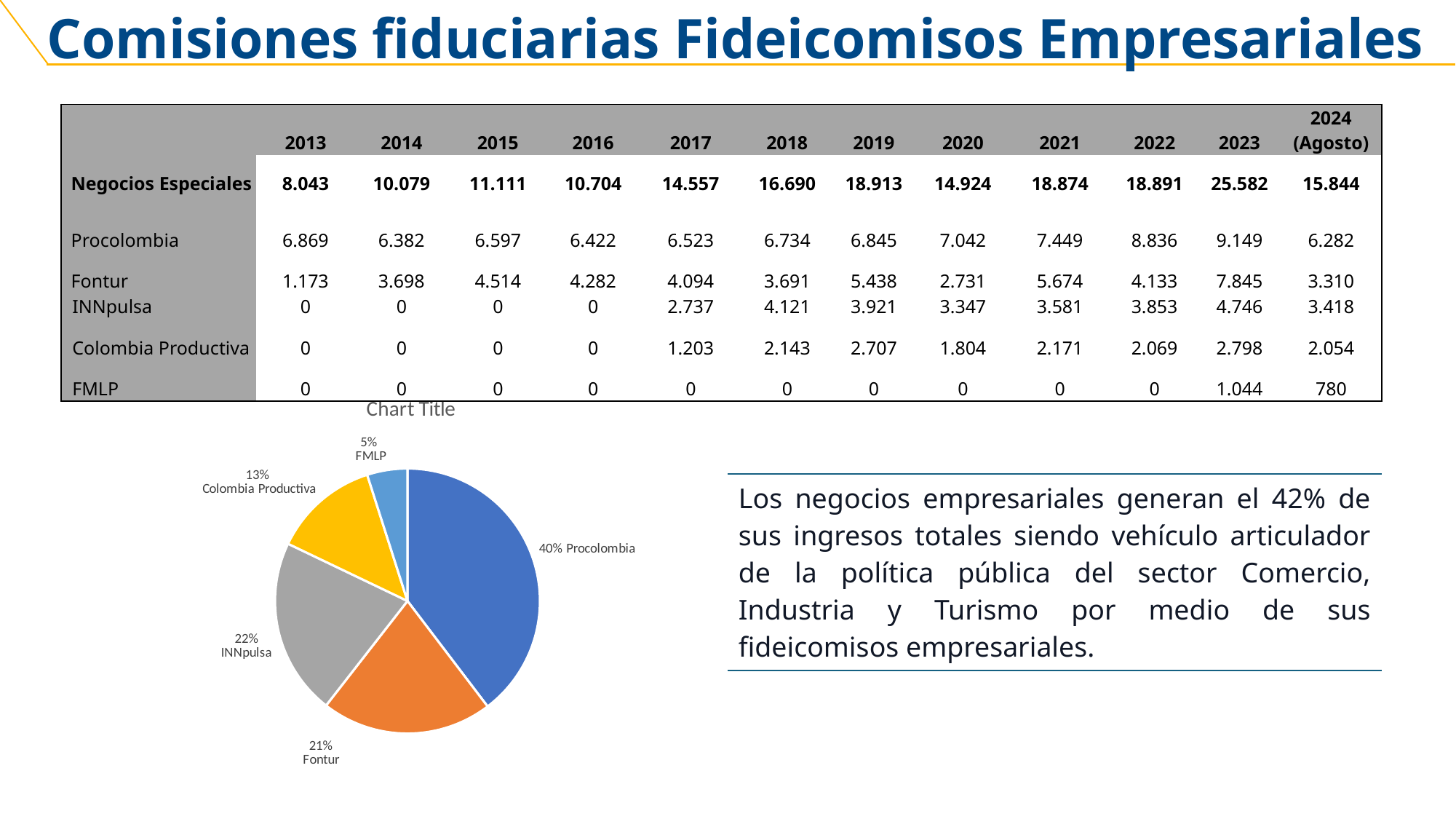
Which slice of the pie chart is the smallest? FMLP What share of the pie does Fontur have? 21% Which slice is larger, Fontur or Colombia Productiva? Fontur What kind of chart is shown on the slide? pie chart What share of the pie does Procolombia have? 40% What is the title shown above the pie chart? Chart Title What share of the pie does FMLP have? 5% Which slice of the pie chart is the largest? Procolombia How many slices does the pie chart have? 5 What is the difference in percentage points between the Procolombia slice and the Colombia Productiva slice? 27